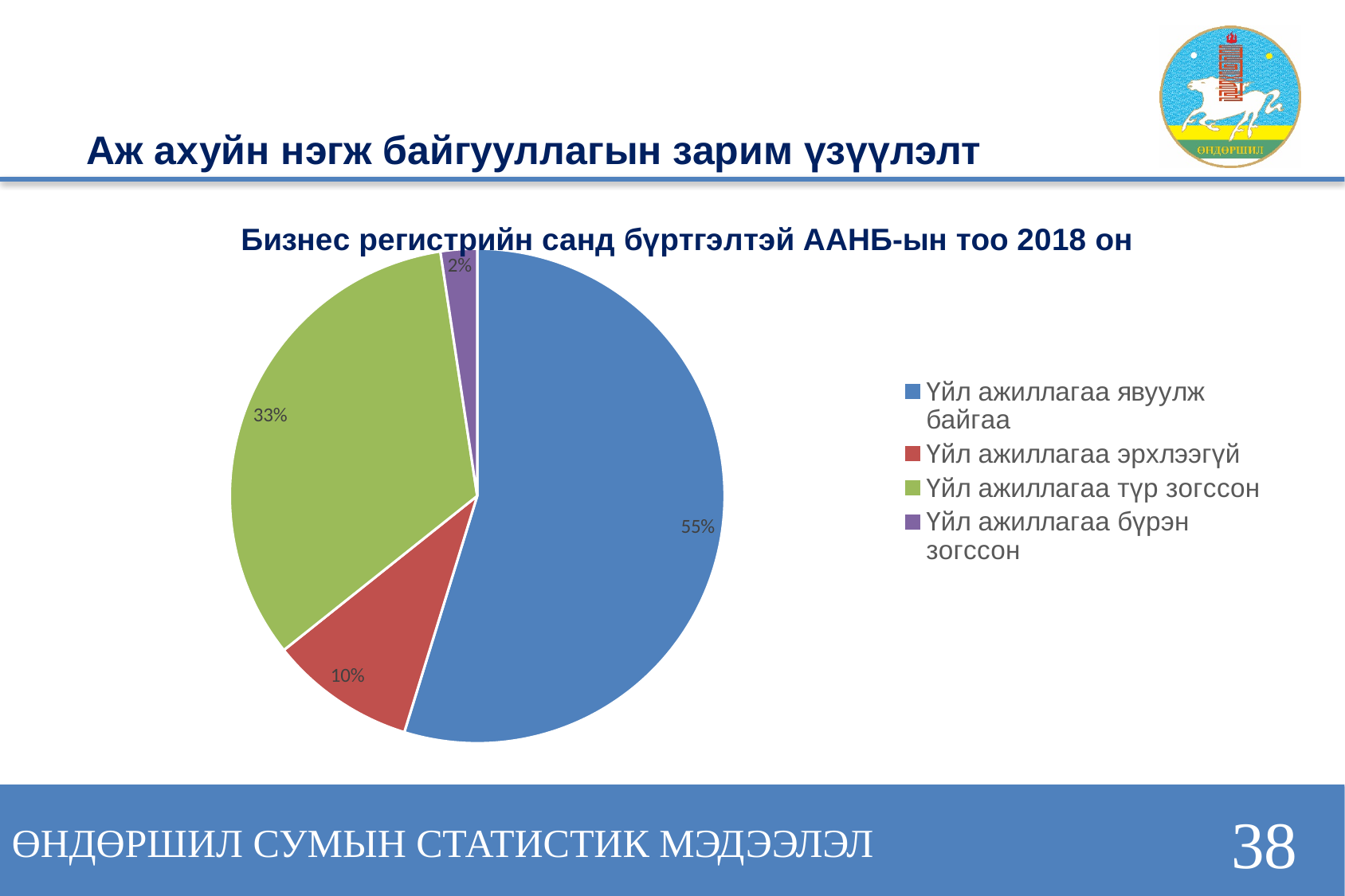
What share of the pie does "Үйл ажиллагаа эрхлээгүй" represent? 10% What is the title of the chart? Бизнес регистрийн санд бүртгэлтэй ААНБ-ын тоо 2018 он What is the difference in percentage points between "Үйл ажиллагаа явуулж байгаа" and "Үйл ажиллагаа түр зогссон"? 22 What share of the pie does "Үйл ажиллагаа түр зогссон" represent? 33% How many categories does the legend list? 4 What share of the pie does "Үйл ажиллагаа бүрэн зогссон" represent? 2% Which is larger: the slice for "Үйл ажиллагаа түр зогссон" or the slice for "Үйл ажиллагаа эрхлээгүй"? Үйл ажиллагаа түр зогссон What colour is the slice for "Үйл ажиллагаа түр зогссон"? Green Which category has the largest slice of the pie? Үйл ажиллагаа явуулж байгаа Which category has the smallest slice of the pie? Үйл ажиллагаа бүрэн зогссон What kind of chart is shown on the slide? Pie chart